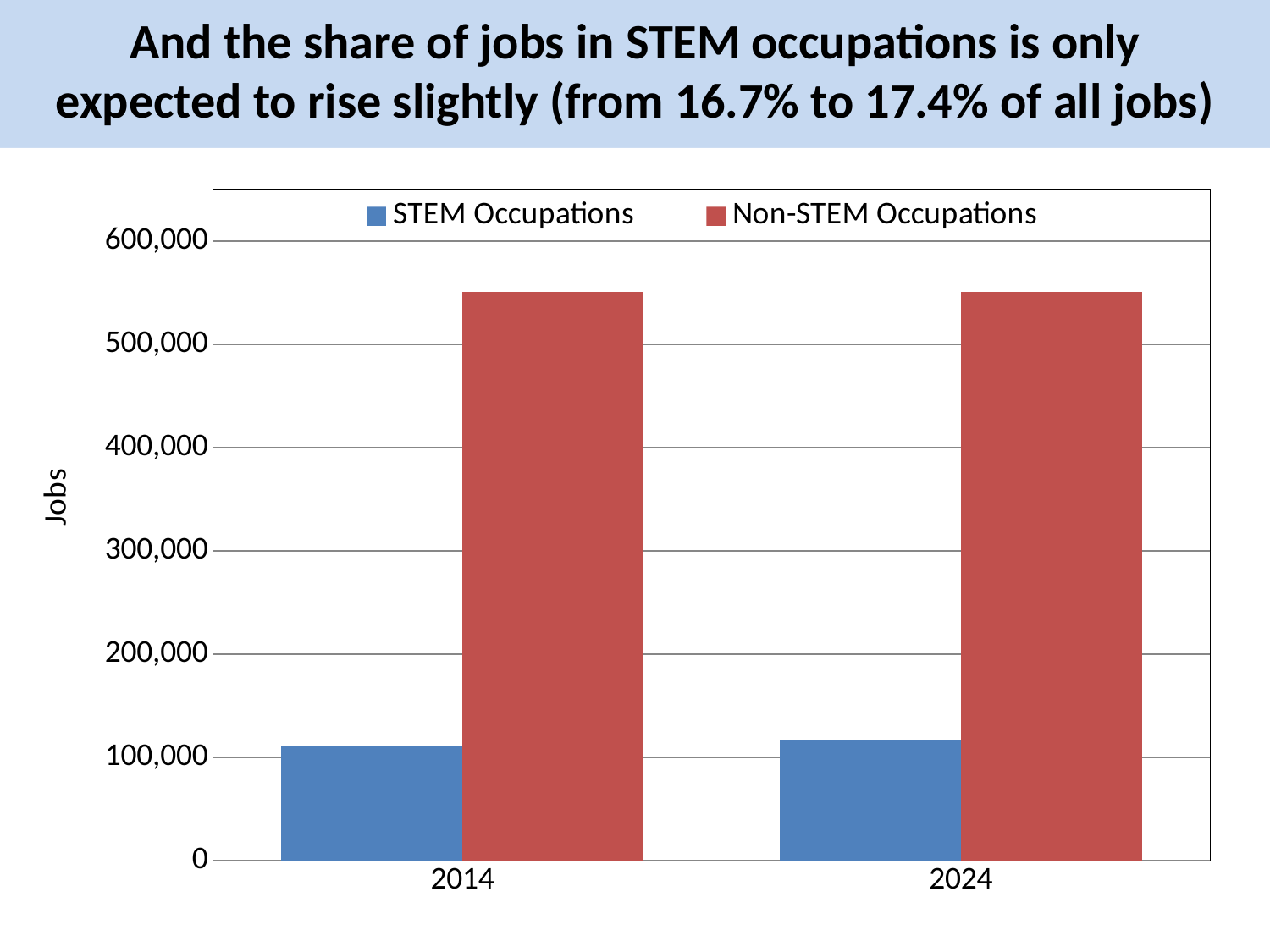
How many year categories are shown on the x axis? 2 Is the value for STEM Occupations in 2014 greater or less than 200,000? less How many series does the legend list? 2 What colour are the bars for Non-STEM Occupations? red Which series has the larger value in 2024, STEM Occupations or Non-STEM Occupations? Non-STEM Occupations Is the value for Non-STEM Occupations in 2024 greater or less than 600,000? less What kind of chart is shown on the slide? bar chart Which series has the larger value in 2014, STEM Occupations or Non-STEM Occupations? Non-STEM Occupations What is the label on the vertical axis? Jobs Is the value for Non-STEM Occupations in 2014 greater or less than 500,000? greater